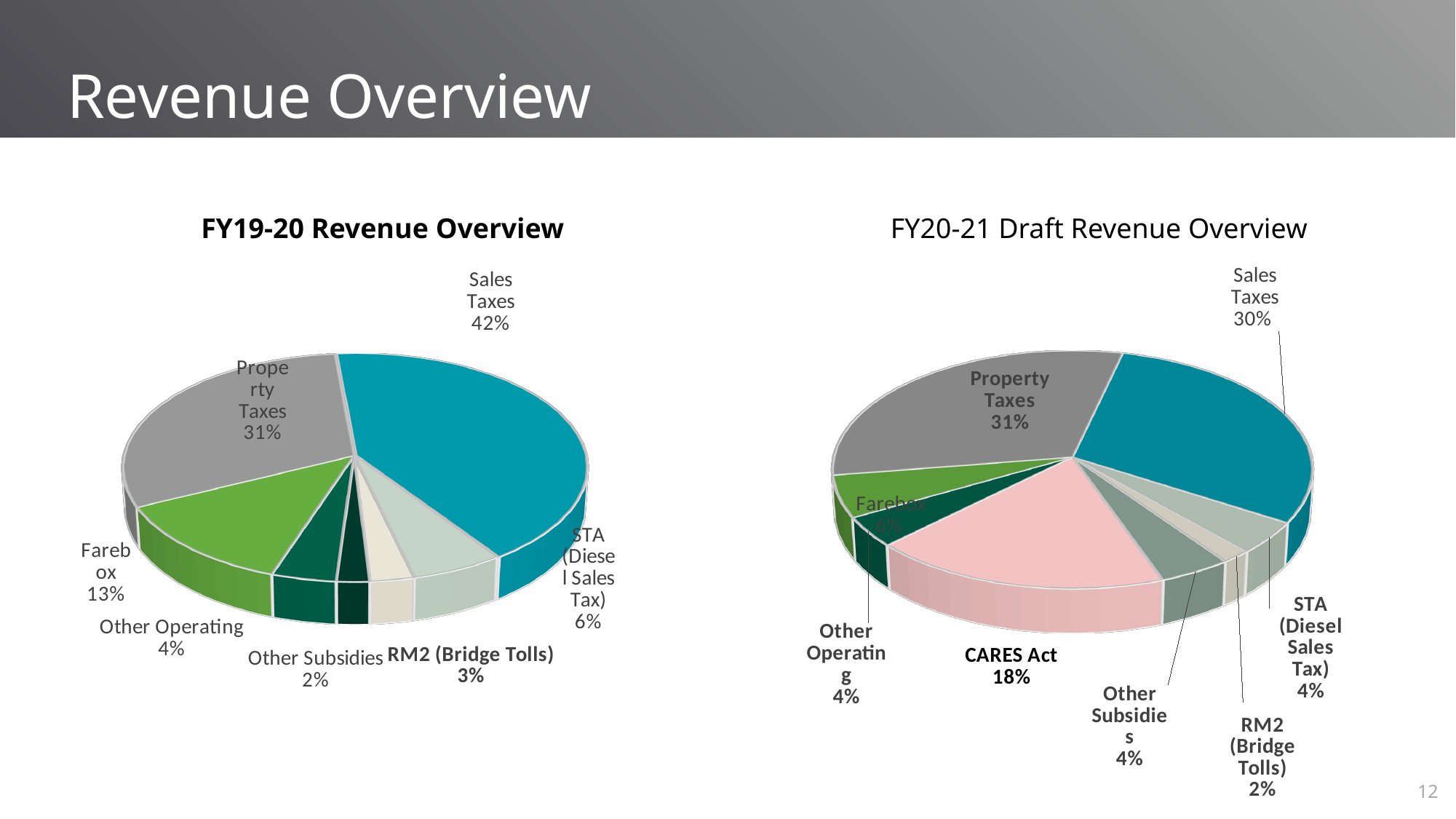
In the FY19-20 Revenue Overview chart, which category has the largest share? Sales Taxes In the FY19-20 Revenue Overview chart, which category has the smallest share? Other Subsidies In the FY20-21 Draft Revenue Overview chart, how many categories are shown? 8 In the FY19-20 Revenue Overview chart, how many categories are shown? 7 In the FY19-20 Revenue Overview chart, what percentage is shown for Farebox? 13% Which is larger: the Farebox share in the FY19-20 chart or the Farebox share in the FY20-21 Draft chart? FY19-20 In the FY19-20 Revenue Overview chart, what share of revenue comes from Sales Taxes? 42% In the FY20-21 Draft Revenue Overview chart, what percentage is shown for CARES Act? 18% What is the difference between the Sales Taxes share in the FY19-20 chart and the Sales Taxes share in the FY20-21 Draft chart? 12 percentage points In the FY20-21 Draft Revenue Overview chart, which category has the largest share? Property Taxes In the FY20-21 Draft Revenue Overview chart, what share of revenue comes from Sales Taxes? 30% What type of chart is used for the FY20-21 Draft Revenue Overview? Pie chart